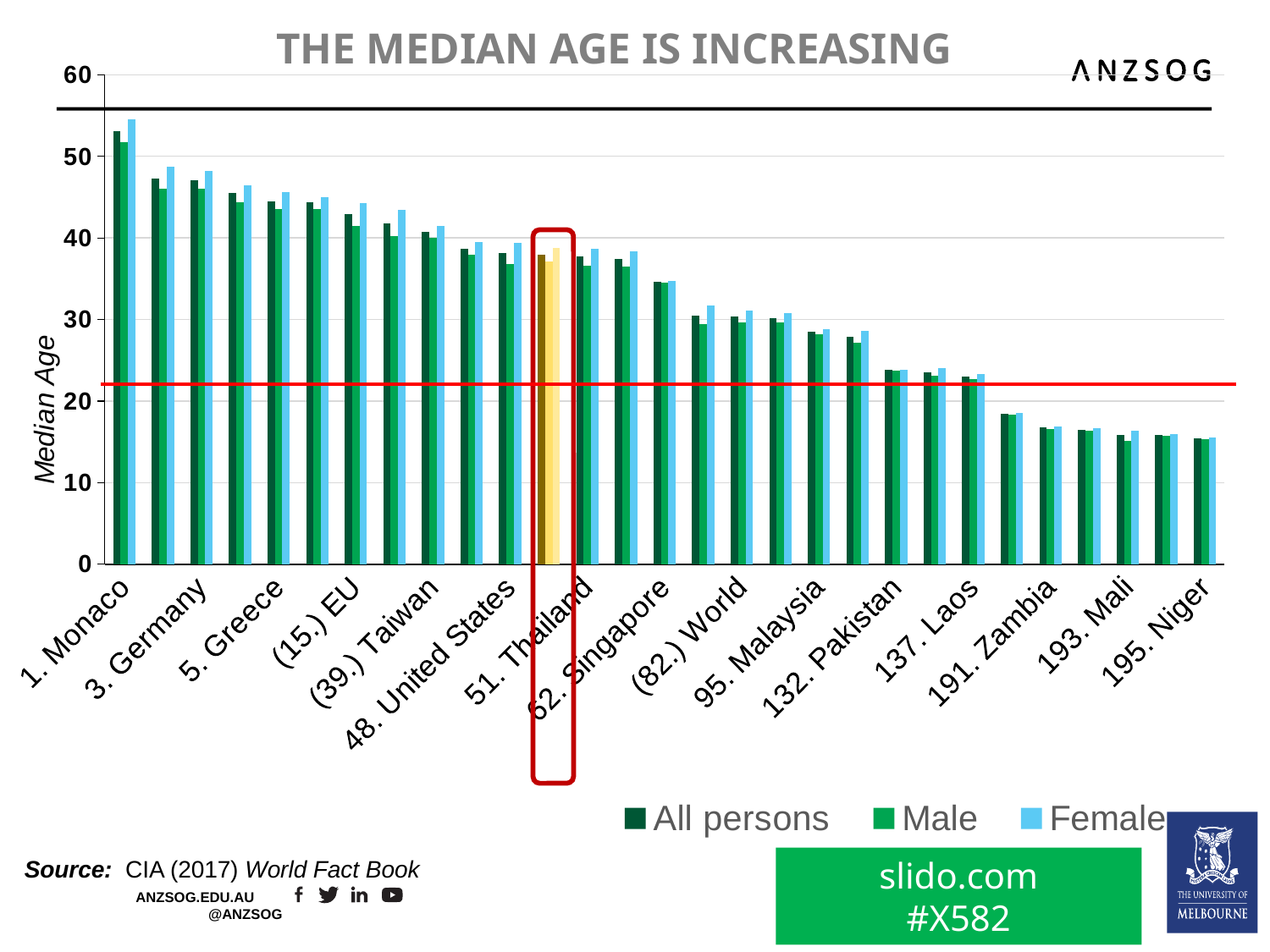
Is the All persons median age for 191. Zambia greater or less than 20? less What kind of chart is shown on the slide? bar chart Is the All persons median age for 51. Thailand greater or less than 30? greater Which country has the lowest median age for All persons? 195. Niger For 1. Monaco, which is higher, the Male or the Female median age? Female Which has a higher All persons median age, 3. Germany or 62. Singapore? 3. Germany Which country is highlighted with a red box on the chart? 51. Thailand Is the All persons median age for 1. Monaco greater or less than 50? greater How many series does the legend list? 3 Which country has the highest median age for All persons? 1. Monaco Do the median age values rise or fall moving from left to right along the x axis? fall